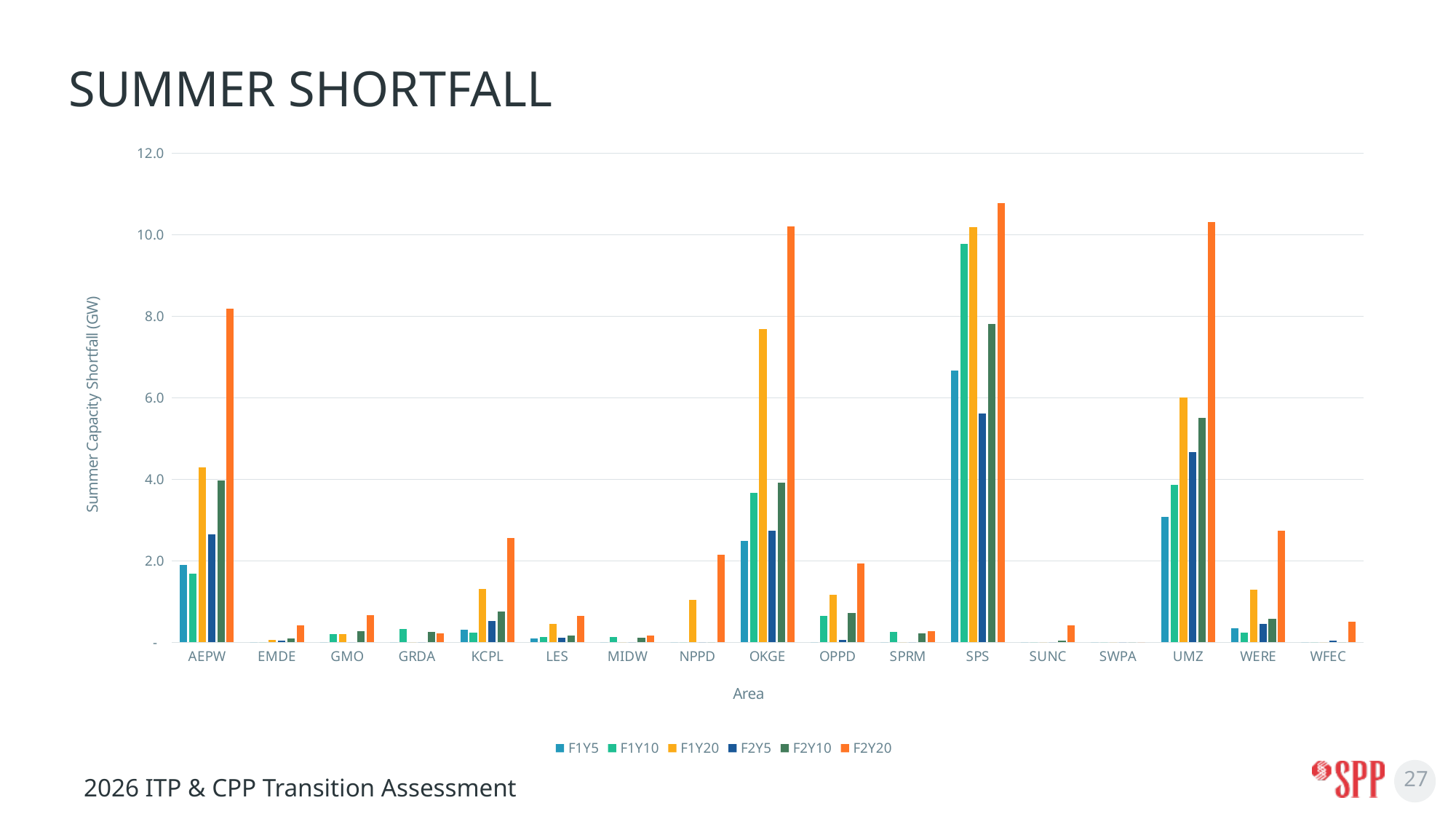
What is the label of the y axis? Summer Capacity Shortfall (GW) Is the F2Y5 value for SPS greater or less than 6.0? less Which area has the highest F1Y5 bar? SPS What kind of chart is shown on the slide? bar chart How many series does the legend list? 6 Which is larger, the F1Y10 value for SPS or the F1Y10 value for UMZ? SPS Is the F2Y20 value for KCPL greater or less than 2.0? greater How many areas are shown along the x axis? 17 Which is larger, the F2Y20 value for AEPW or the F2Y20 value for OKGE? OKGE Is the F1Y20 value for OKGE greater or less than 6.0? greater Which area has the highest F1Y20 bar? SPS